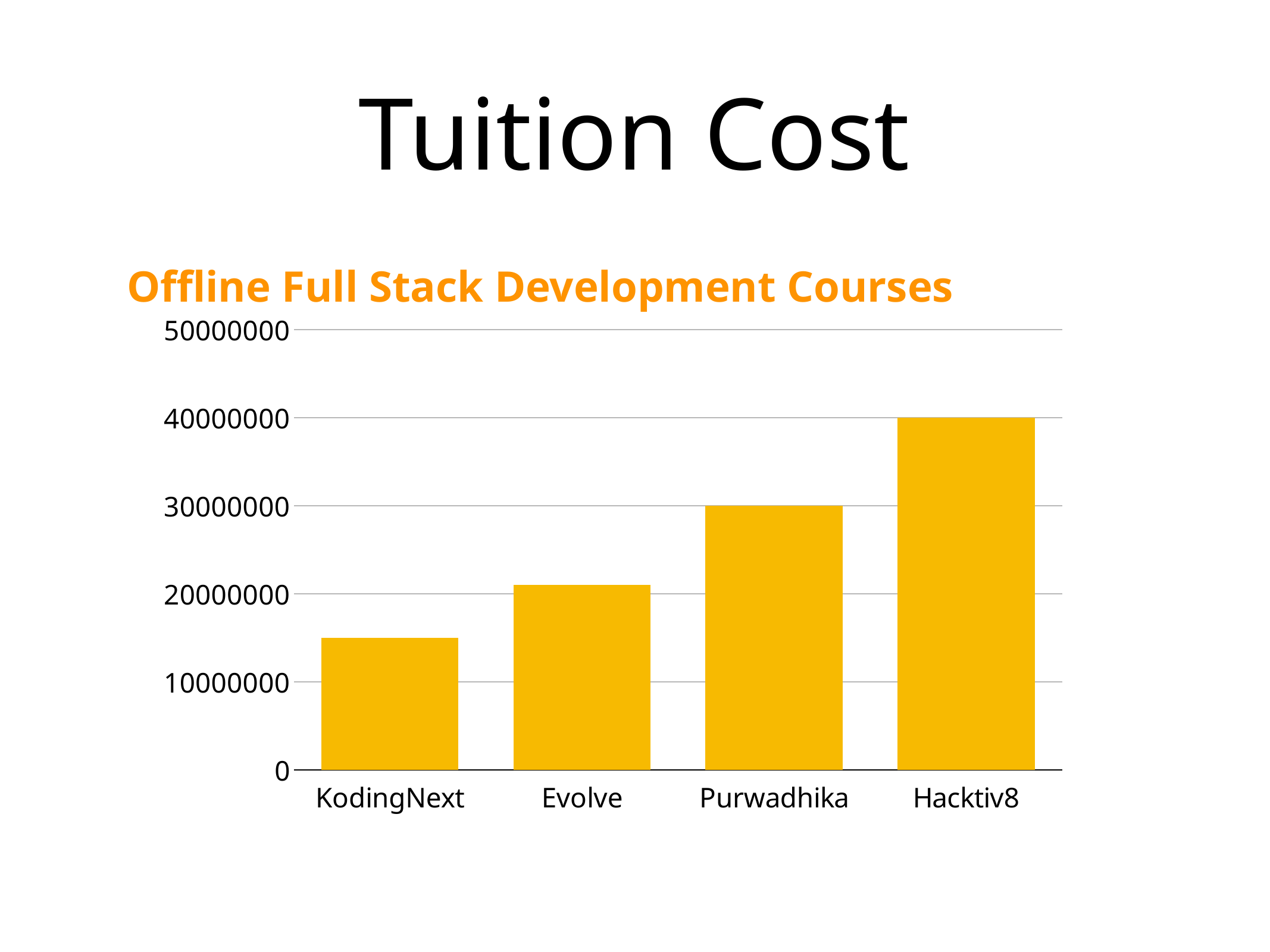
Is the tuition cost for Evolve greater or less than 20000000? greater Do the tuition costs rise or fall from left to right across the chart? rise What is the tuition cost for Hacktiv8? 40000000 Which has a higher tuition cost, Evolve or Purwadhika? Purwadhika Is the tuition cost for KodingNext greater or less than 20000000? less Which course provider has the lowest tuition cost? KodingNext Which course provider has the highest tuition cost? Hacktiv8 What is the difference in tuition cost between Hacktiv8 and Purwadhika? 10000000 What type of chart is shown on the slide? bar chart What is the tuition cost for Purwadhika? 30000000 How many course providers are shown in the chart? 4 Is the tuition cost for KodingNext greater or less than 10000000? greater